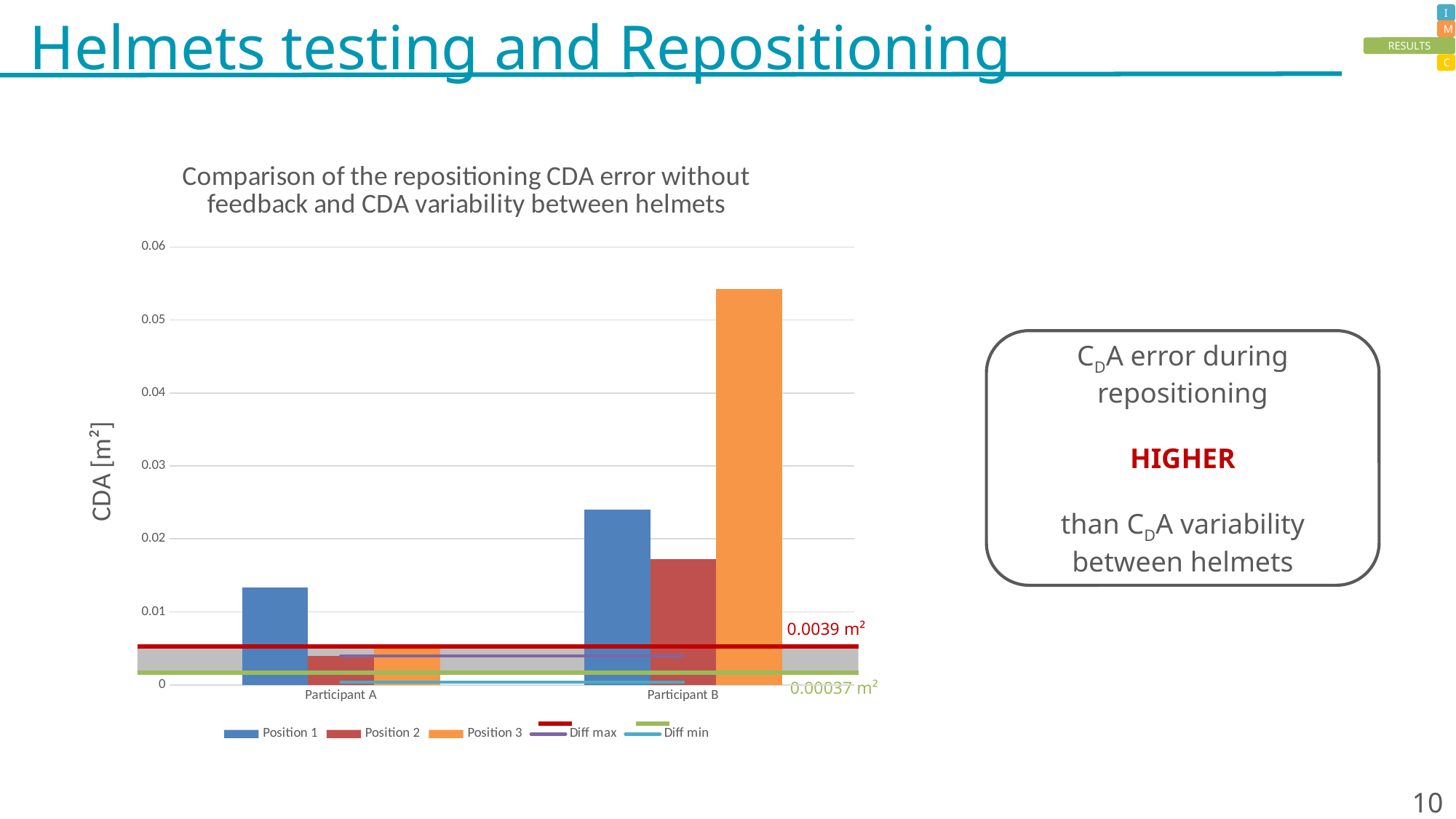
Which participant has the larger Position 1 value? Participant B Which bar is the highest in the chart? Position 3 for Participant B Is the Position 3 value for Participant B greater or less than 0.05? greater How many labelled series does the legend list? 5 How many participant categories are shown on the x axis? 2 What kind of chart is shown on the slide? combination bar and line chart Is the Position 1 value for Participant B greater or less than 0.02? greater Is the Position 2 value for Participant B greater or less than 0.02? less What value is printed next to the green horizontal line? 0.00037 m² What value is printed next to the red horizontal line? 0.0039 m² What is the label of the y axis? CDA [m²]